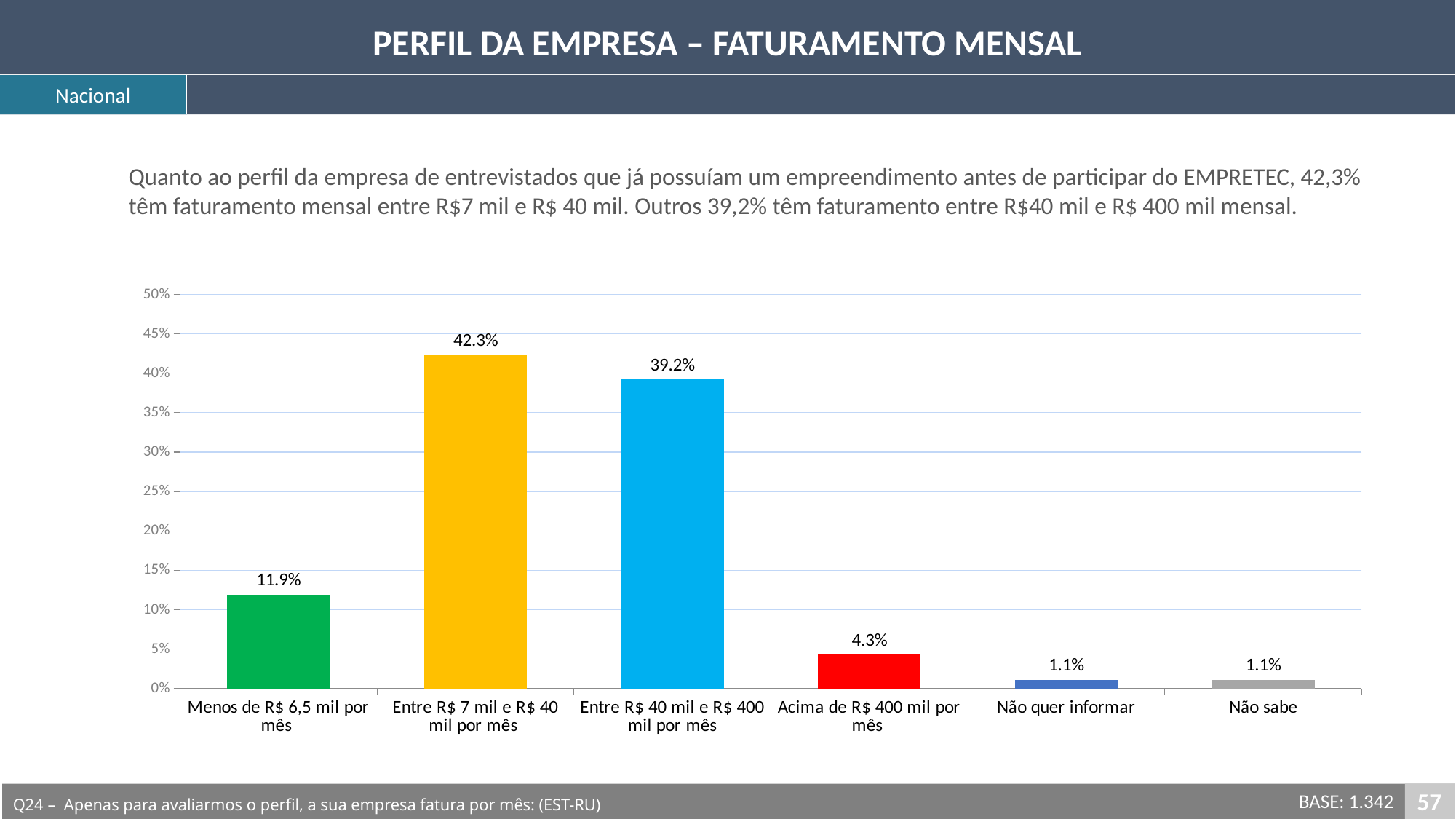
What is the difference between the values for "Entre R$ 7 mil e R$ 40 mil por mês" and "Entre R$ 40 mil e R$ 400 mil por mês"? 3.1% How many categories are shown on the x axis? 6 Which category has the highest value? Entre R$ 7 mil e R$ 40 mil por mês What is the difference between the values for "Menos de R$ 6,5 mil por mês" and "Não sabe"? 10.8% What is the value for "Menos de R$ 6,5 mil por mês"? 11.9% What is the value for "Não quer informar"? 1.1% What is the value for "Entre R$ 7 mil e R$ 40 mil por mês"? 42.3% Which is larger, the value for "Menos de R$ 6,5 mil por mês" or the value for "Acima de R$ 400 mil por mês"? Menos de R$ 6,5 mil por mês What kind of chart is shown on the slide? bar chart Is the value for "Entre R$ 40 mil e R$ 400 mil por mês" greater or less than 35%? greater What is the value for "Acima de R$ 400 mil por mês"? 4.3% What colour is the bar for "Entre R$ 7 mil e R$ 40 mil por mês"? yellow